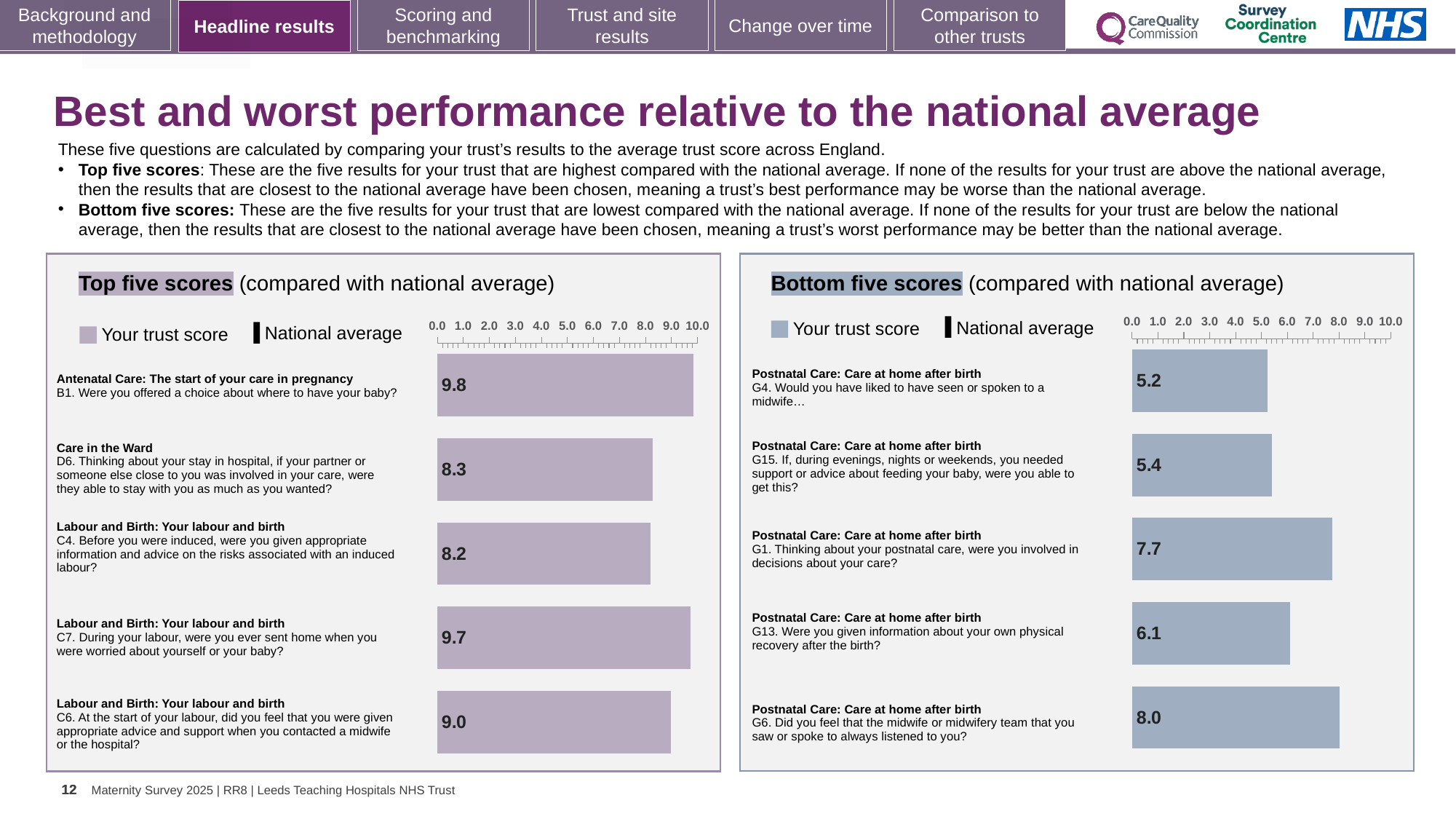
In the Top five scores chart, which has the larger trust score, C7 or C6? C7 In the Top five scores chart, what is the difference between the trust scores for B1 and D6? 1.5 In the Bottom five scores chart, which question has the lowest trust score? G4. Would you have liked to have seen or spoken to a midwife… In the Bottom five scores chart, which question has the highest trust score? G6. Did you feel that the midwife or midwifery team that you saw or spoke to always listened to you? How many questions are shown in the Bottom five scores chart? 5 In the Bottom five scores chart, what is the trust score for G13 (information about your own physical recovery after the birth)? 6.1 In the Top five scores chart, what is the trust score for B1 (Were you offered a choice about where to have your baby)? 9.8 In the Top five scores chart, which question has the highest trust score? B1. Were you offered a choice about where to have your baby? What type of chart is used in the Top five scores panel? Bar chart In the Bottom five scores chart, what is the trust score for G4 (Would you have liked to have seen or spoken to a midwife)? 5.2 In the Bottom five scores chart, what is the difference between the trust scores for G6 and G4? 2.8 In the Top five scores chart, what is the trust score for C6 (advice and support when you contacted a midwife or the hospital at the start of labour)? 9.0